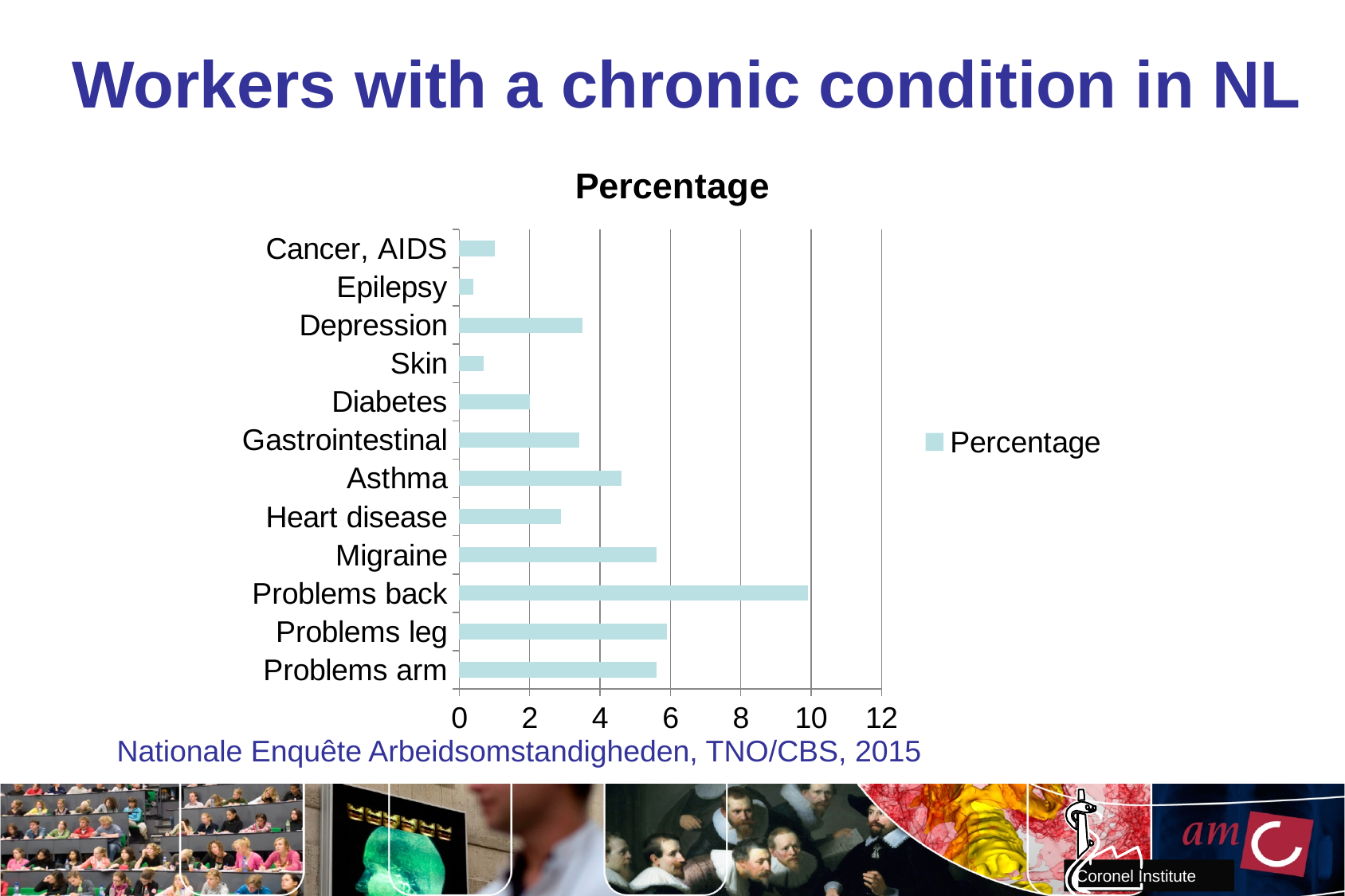
Which is larger, the value for Depression or the value for Diabetes? Depression What is the title of the chart? Percentage Is the value for Depression greater or less than 4? less How many series does the legend list? 1 Is the value for Cancer, AIDS greater or less than 2? less Is the value for Asthma greater or less than 4? greater Which condition has the highest percentage? Problems back Which condition has the lowest percentage? Epilepsy How many categories (conditions) are plotted in the chart? 12 What kind of chart is shown on the slide? bar chart Which is larger, the value for Asthma or the value for Heart disease? Asthma